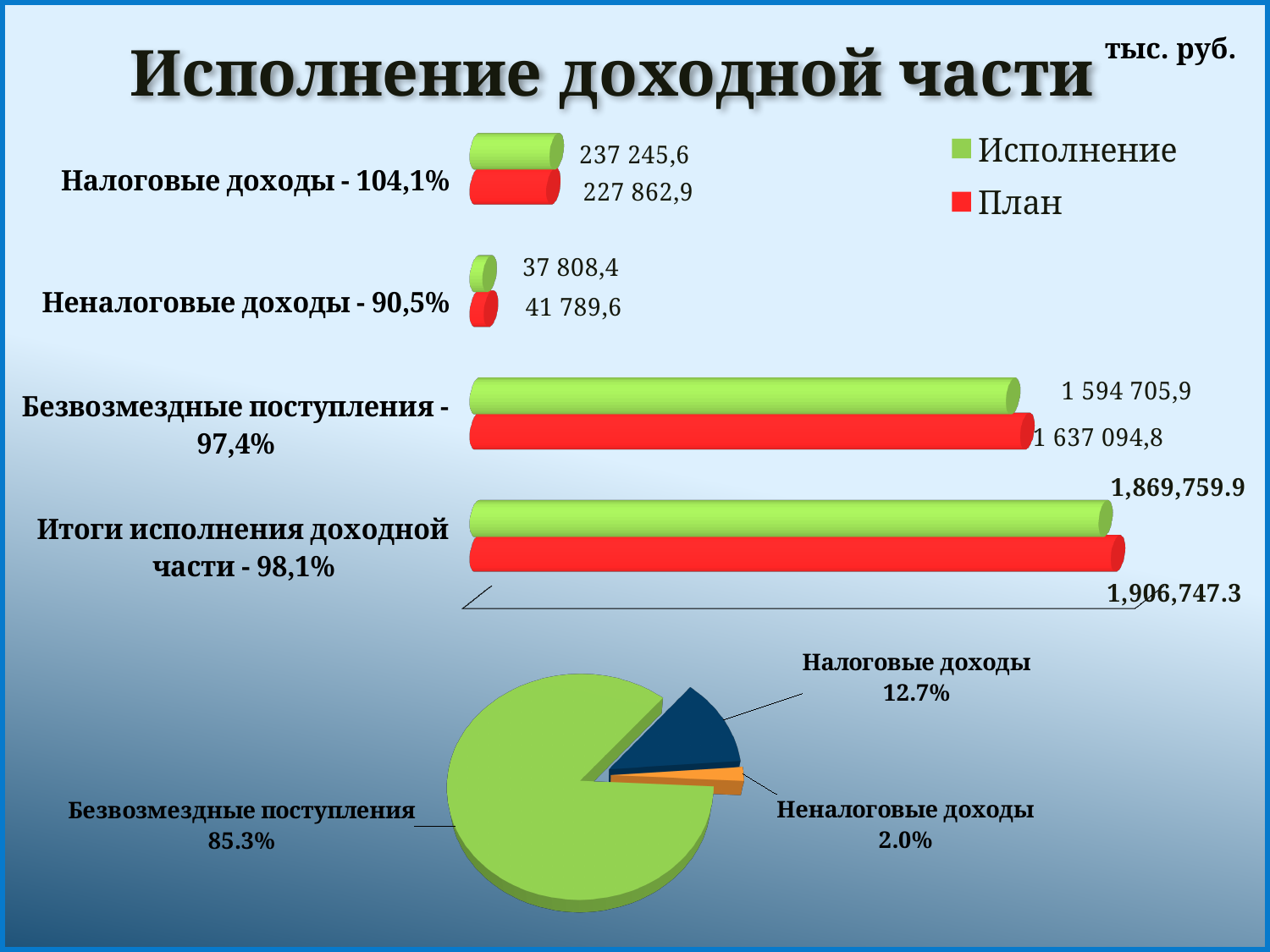
In the bar chart, what colour represents the План series? Red In the bar chart, for Неналоговые доходы, which is larger: Исполнение or План? План In the pie chart, which slice is the smallest? Неналоговые доходы In the bar chart, what is the План value for Неналоговые доходы? 41 789,6 In the bar chart, what is the Исполнение value for Налоговые доходы? 237 245,6 In the bar chart, what is the Исполнение value for Итоги исполнения доходной части? 1,869,759.9 In the pie chart, what share does Безвозмездные поступления have? 85.3% What type of chart is the top chart on the slide? Bar chart In the bar chart, how many series does the legend list? 2 In the bar chart, which category has the lowest Исполнение value? Неналоговые доходы In the bar chart, what is the План value for Безвозмездные поступления? 1 637 094,8 In the bar chart, what is the difference between the Исполнение and План values for Налоговые доходы? 9 382,7